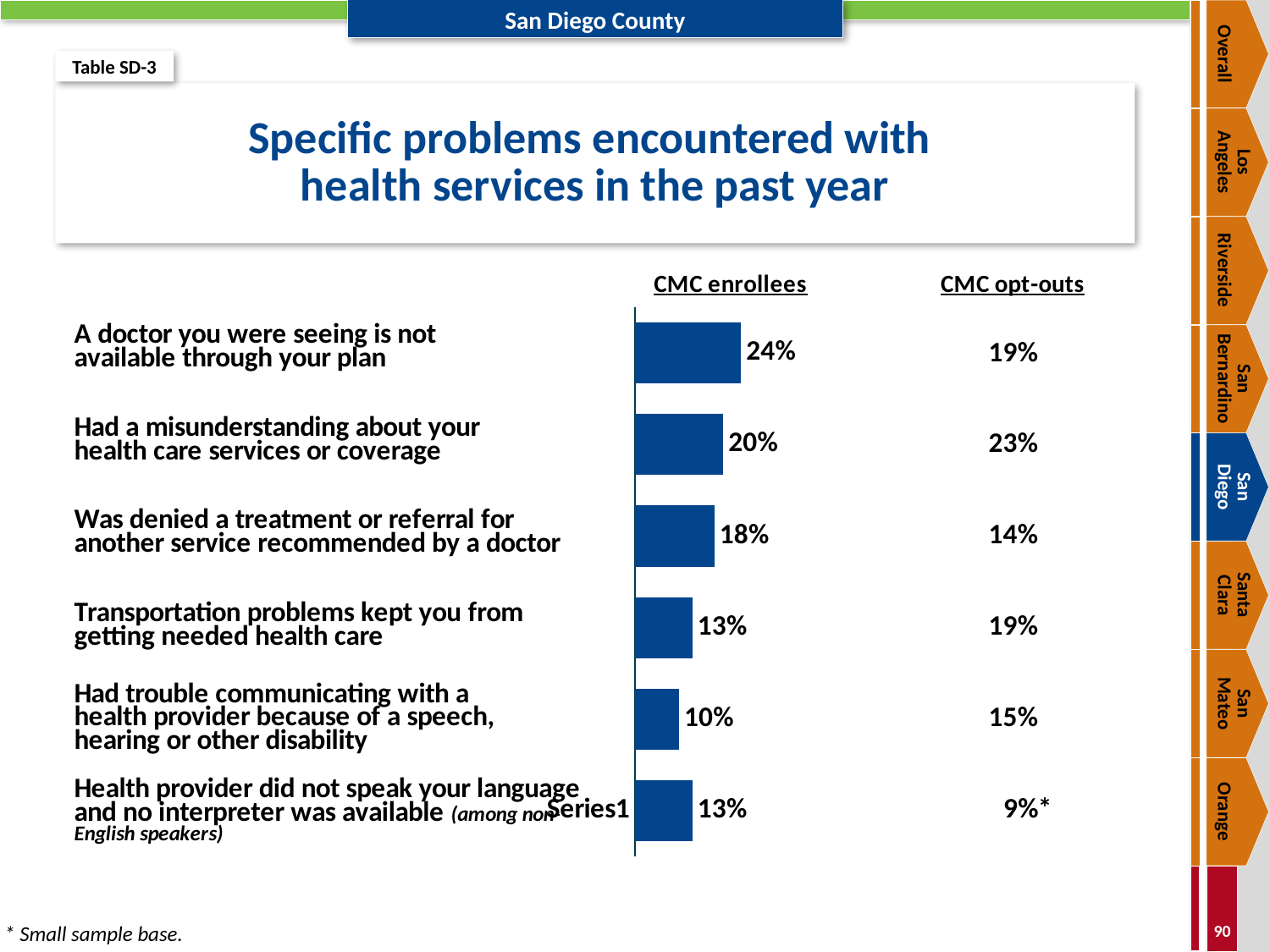
What percentage of CMC enrollees said a doctor they were seeing is not available through their plan? 24% What percentage of CMC enrollees had a misunderstanding about their health care services or coverage? 20% What percentage of CMC enrollees were denied a treatment or referral for another service recommended by a doctor? 18% Among CMC enrollees, which is larger: the percentage for 'Had a misunderstanding about your health care services or coverage' or for 'Was denied a treatment or referral for another service recommended by a doctor'? Had a misunderstanding about your health care services or coverage How many problem categories are shown in the chart? 6 What percentage of CMC enrollees had trouble communicating with a health provider because of a speech, hearing or other disability? 10% Which problem has the highest percentage among CMC enrollees? A doctor you were seeing is not available through your plan Do the CMC enrollees bar values generally rise or fall from the top category to the bottom category? fall What is the difference between the CMC enrollees percentages for 'A doctor you were seeing is not available through your plan' and 'Transportation problems kept you from getting needed health care'? 11% What is the title of the chart? Specific problems encountered with health services in the past year What kind of chart is used to show the CMC enrollees values? bar chart Which problem has the lowest percentage among CMC enrollees? Had trouble communicating with a health provider because of a speech, hearing or other disability